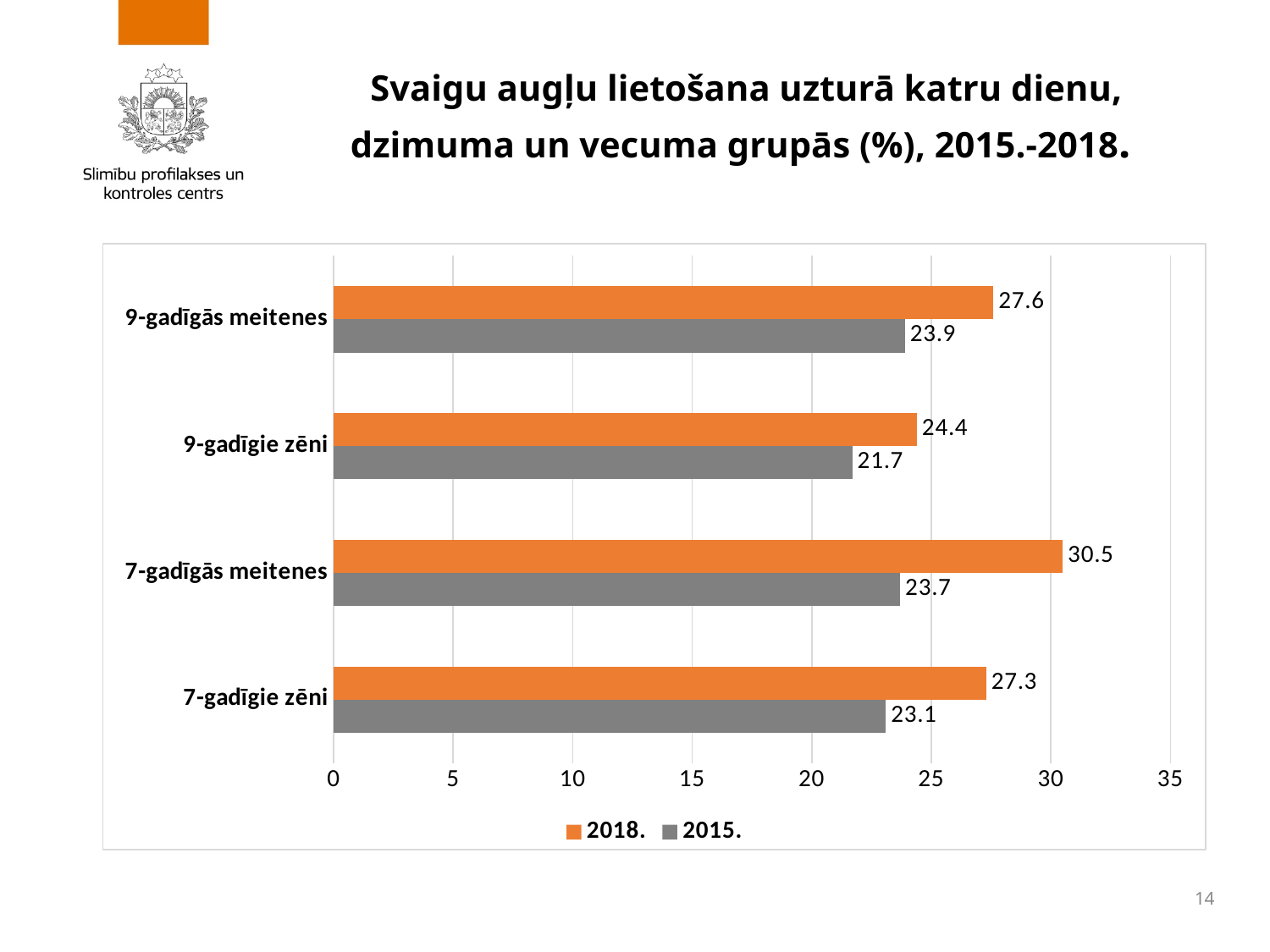
Which colour represents the 2015. series? grey What is the 2015. value for 7-gadīgie zēni? 23.1 Which category has the highest 2018. value? 7-gadīgās meitenes Which category has the lowest 2015. value? 9-gadīgie zēni What kind of chart is shown on the slide? bar chart What is the 2015. value for 9-gadīgie zēni? 21.7 Is the 2018. value for 7-gadīgās meitenes greater or less than 30? greater What is the 2018. value for 7-gadīgās meitenes? 30.5 What is the difference between the 2018. and 2015. values for 9-gadīgās meitenes? 3.7 How many categories are shown on the chart? 4 How many series does the legend list? 2 Which is larger for 9-gadīgie zēni, the 2018. value or the 2015. value? 2018.